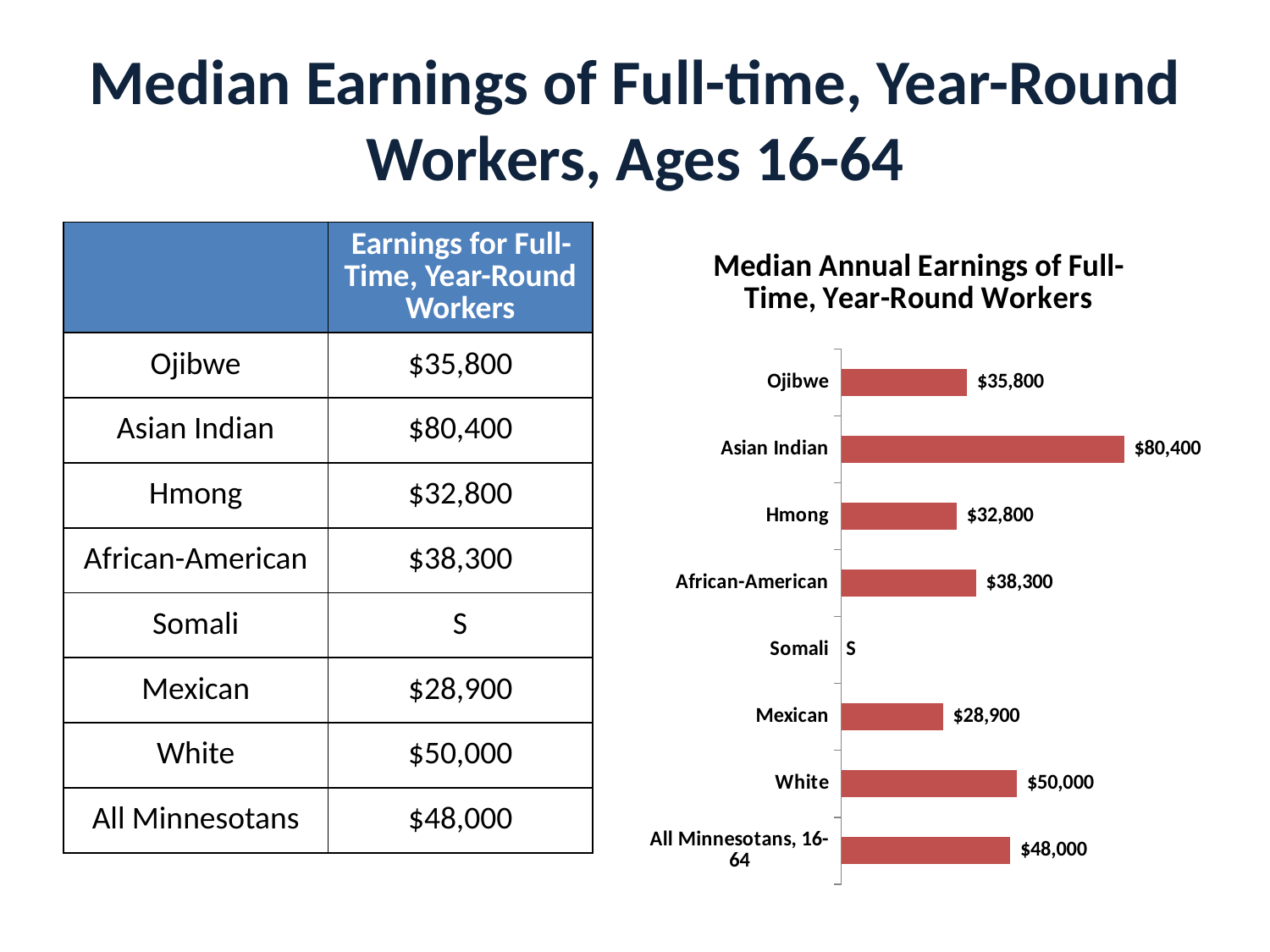
What type of chart is used to show median annual earnings? Bar chart How many groups are listed on the category axis of the chart? 8 What is the median annual earnings value shown for White workers in the chart? $50,000 What is the median annual earnings value shown for Hmong workers in the chart? $32,800 Which group has the highest median annual earnings in the chart? Asian Indian What is the difference between the median annual earnings of Asian Indian workers and All Minnesotans, 16-64 in the chart? $32,400 What is the median annual earnings value shown for All Minnesotans, 16-64 in the chart? $48,000 What label is shown instead of a dollar value for the Somali group in the chart? S Among the groups with a dollar value shown, which has the lowest median annual earnings in the chart? Mexican Which group has higher median annual earnings in the chart, Ojibwe or African-American? African-American What is the difference between the median annual earnings of White workers and Mexican workers in the chart? $21,100 What is the median annual earnings value shown for Asian Indian workers in the chart? $80,400